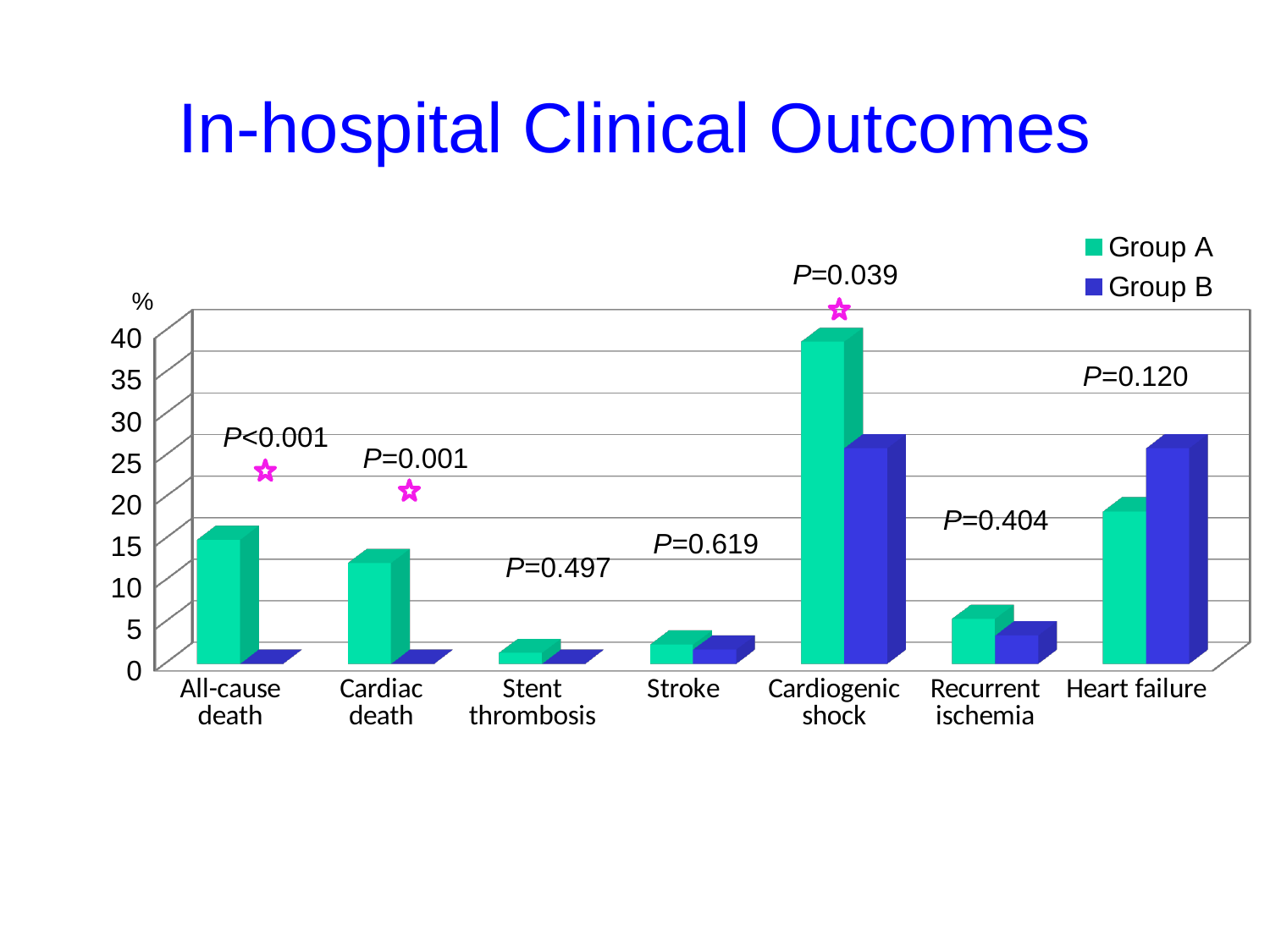
Which category has the highest value for Group A? Cardiogenic shock Is the Group A value for Cardiogenic shock greater or less than 35? greater Is the Group B value for Cardiogenic shock greater or less than 20? greater What kind of chart is shown on the slide? Bar chart What are the two entries in the chart legend? Group A and Group B How many series does the legend list? 2 For Heart failure, which group has the larger value, Group A or Group B? Group B How many outcome categories are shown on the x axis? 7 Is the Group A value for All-cause death greater or less than 10? greater What P value is printed above the Cardiogenic shock bars? P=0.039 For All-cause death, which group has the larger value, Group A or Group B? Group A